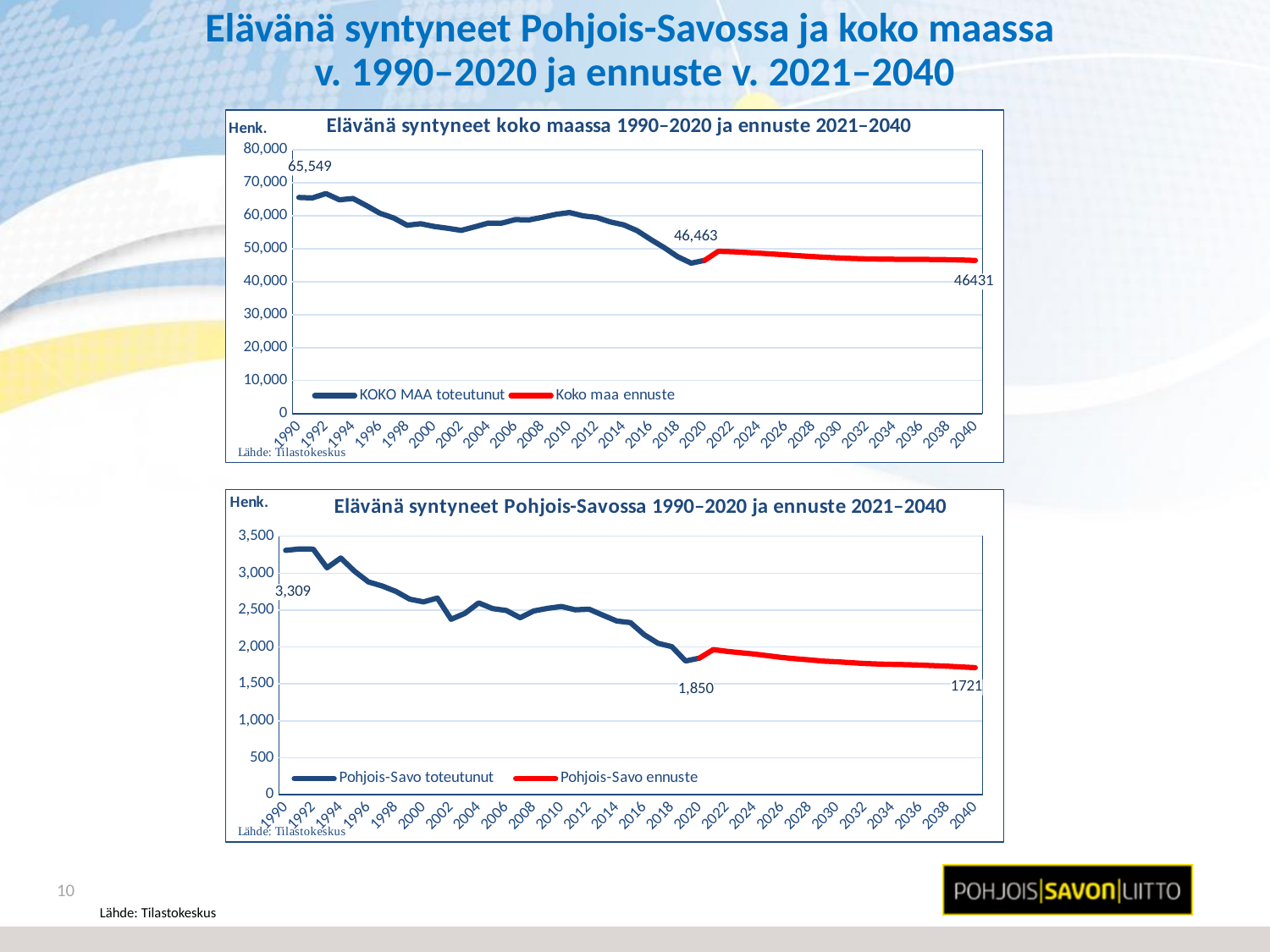
In the bottom chart (Pohjois-Savossa), what is the value labelled for 1990? 3,309 In the top chart (koko maassa), what is the value labelled for 2020? 46,463 In the top chart (koko maassa), what is the value labelled for 1990? 65,549 In the bottom chart (Pohjois-Savossa), what is the value labelled for 2020? 1,850 In the top chart (koko maassa), is the value for 2002 greater or less than 60,000? less In the top chart (koko maassa), what is the difference between the 1990 value and the 2020 value? 19,086 What type of chart is the top chart, 'Elävänä syntyneet koko maassa 1990–2020 ja ennuste 2021–2040'? Line chart In the bottom chart (Pohjois-Savossa), what is the forecast value labelled for 2040? 1721 In the bottom chart (Pohjois-Savossa), what is the difference between the 1990 value and the 2020 value? 1,459 In the top chart (koko maassa), what is the forecast value labelled for 2040? 46431 How many series does the legend of the top chart (koko maassa) list? 2 In the bottom chart (Pohjois-Savossa), do the values generally rise or fall from 1990 to 2040? Fall